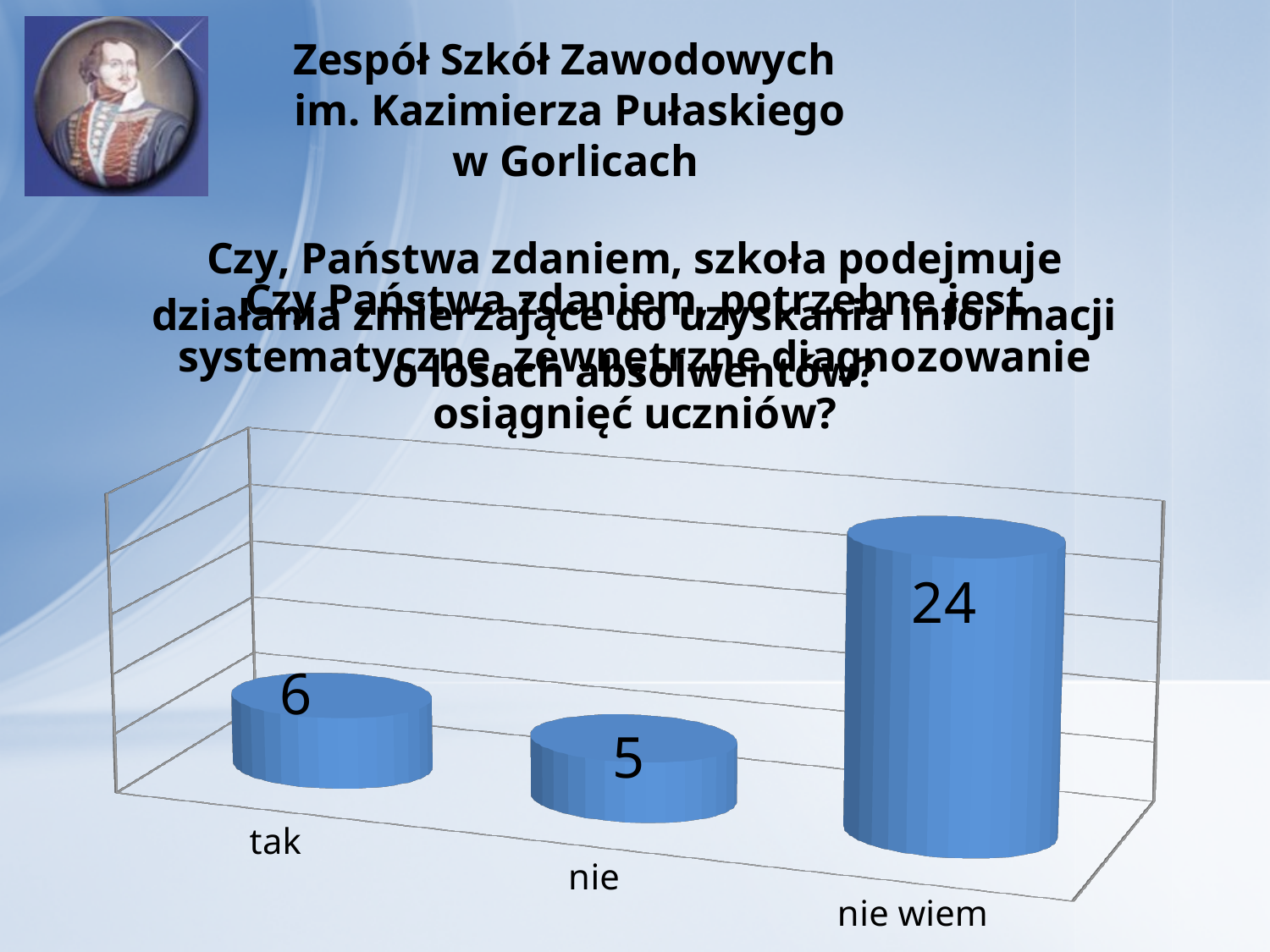
Which is larger, the value for "tak" or the value for "nie wiem"? nie wiem What is the difference between the values for "tak" and "nie"? 1 Which category has the lowest value? nie What colour are the bars in the chart? blue What is the total of all three values shown in the chart? 35 What kind of chart is shown on the slide? bar chart What is the difference between the values for "nie wiem" and "tak"? 18 What is the value for "nie wiem"? 24 What is the value for "tak"? 6 How many categories are shown in the chart? 3 Which category has the highest value? nie wiem What is the value for "nie"? 5